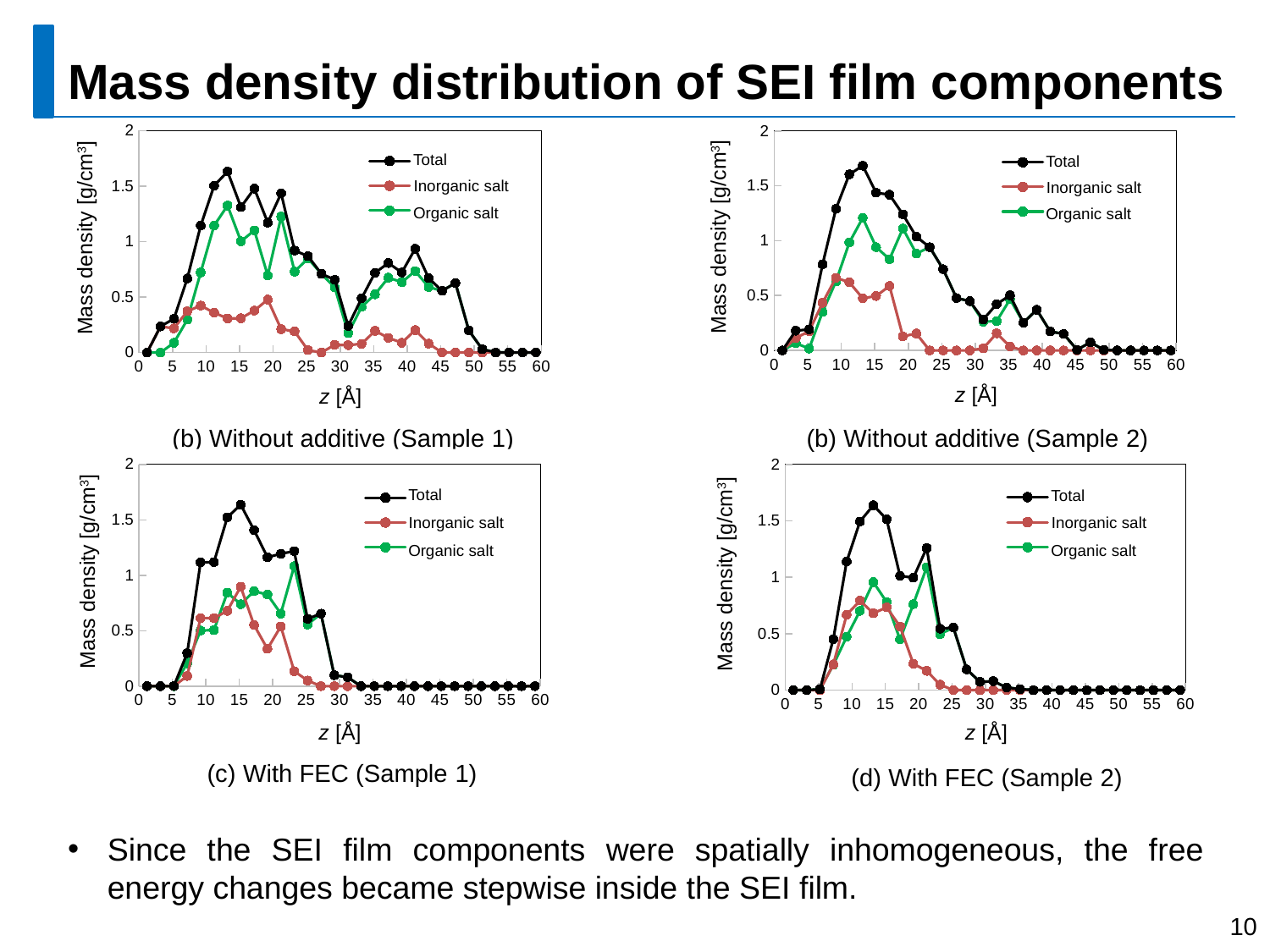
In the top-right chart, '(b) Without additive (Sample 2)', is the Inorganic salt value at z = 9 Å greater or less than 0.5? greater In the bottom-left chart, '(c) With FEC (Sample 1)', is the Total value at z = 15 Å greater or less than 1.5? greater What is the y-axis label of the bottom-left chart, '(c) With FEC (Sample 1)'? Mass density [g/cm³] What kind of chart is the top-left chart, '(b) Without additive (Sample 1)'? line chart How many series does the legend list in the bottom-right chart, '(d) With FEC (Sample 2)'? 3 In the top-right chart, '(b) Without additive (Sample 2)', does the Total series rise or fall between z = 1 Å and z = 13 Å? rise In the top-left chart, '(b) Without additive (Sample 1)', which series is higher at z = 13 Å: Organic salt or Inorganic salt? Organic salt In the bottom-right chart, '(d) With FEC (Sample 2)', which series is higher at z = 21 Å: Organic salt or Inorganic salt? Organic salt In the bottom-left chart, '(c) With FEC (Sample 1)', does the Total series rise or fall between z = 15 Å and z = 31 Å? fall In the top-right chart, '(b) Without additive (Sample 2)', which colour is used for the Inorganic salt series? red In the bottom-right chart, '(d) With FEC (Sample 2)', is the Inorganic salt value at z = 11 Å greater or less than 0.5? greater